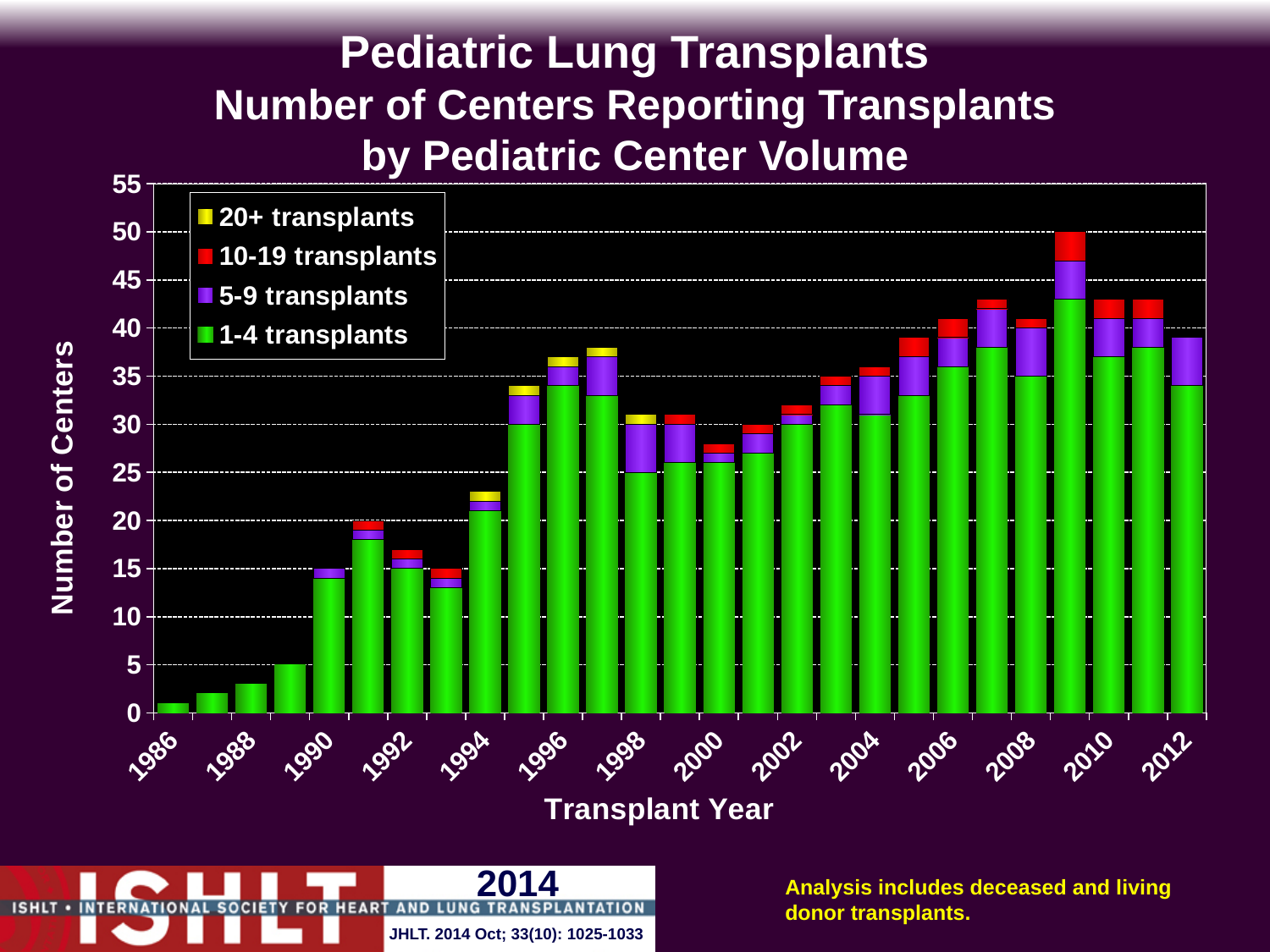
Which transplant year has the highest total number of centers? 2009 How many series does the legend list? 4 Is the total number of centers for 2012 greater or less than 35? greater Is the total number of centers for 2000 greater or less than 30? less Do the total number of centers rise or fall from 1986 to 1989? rise Is the total number of centers for 1991 greater or less than 25? less How many transplant years (bars) are plotted on the chart? 27 Which year has a larger total number of centers, 1990 or 1994? 1994 What kind of chart is shown on the slide? Stacked bar chart What is the label of the x axis? Transplant Year Which transplant year has the lowest total number of centers? 1986